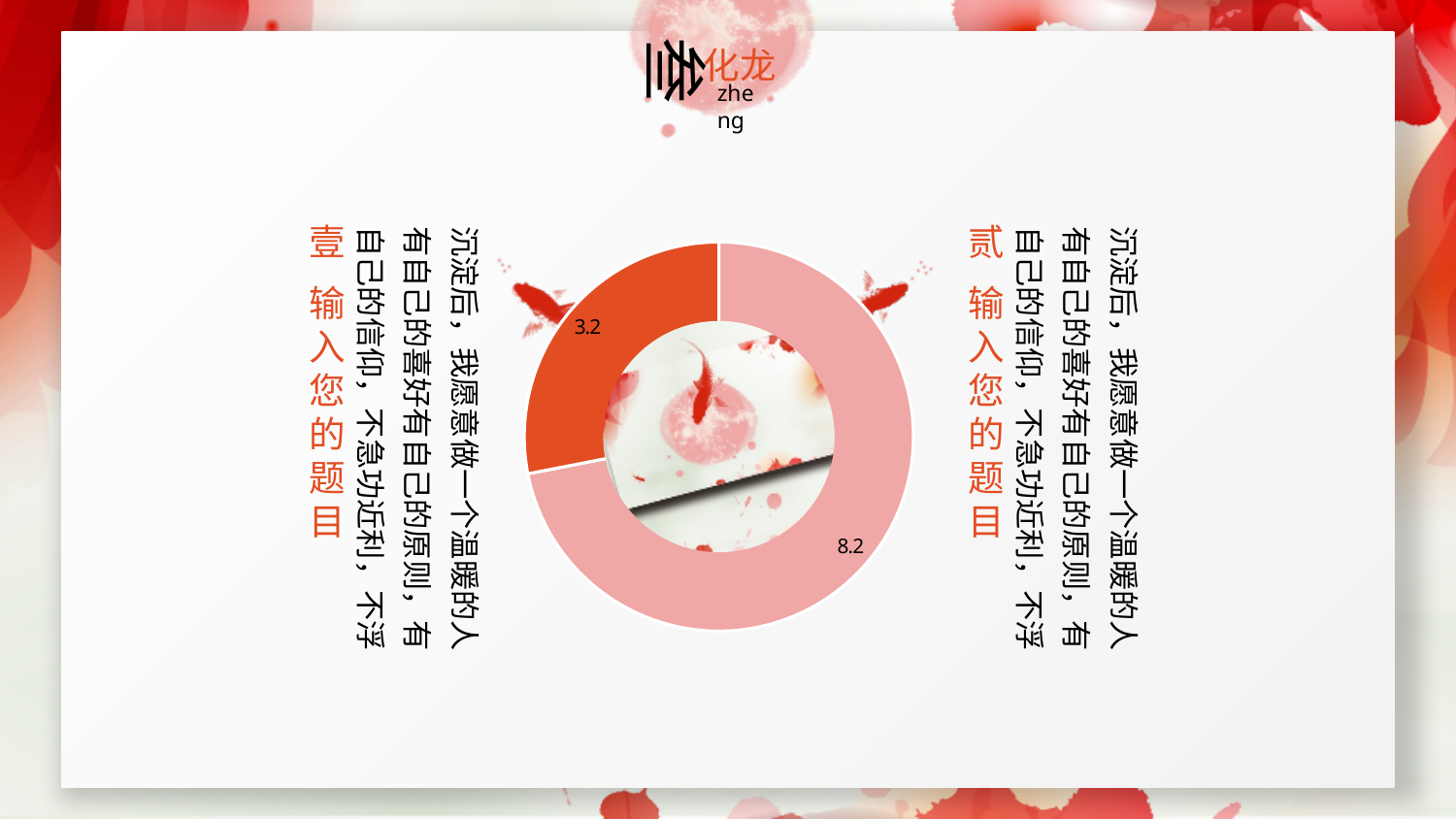
What kind of chart is shown on the slide? Doughnut chart What value is labelled on the larger, pink slice of the doughnut chart? 8.2 What is the total of the two values shown in the doughnut chart? 11.4 What is the difference between the two slice values in the doughnut chart? 5 How many slices does the doughnut chart have? 2 What value is labelled on the smaller, orange-red slice of the doughnut chart? 3.2 Is the value of the pink slice greater or less than 5? greater Which slice is larger in the doughnut chart, the pink one or the orange-red one? The pink one Does the doughnut chart display a legend? No What is the highest value shown in the doughnut chart? 8.2 What is the lowest value shown in the doughnut chart? 3.2 What colour is the slice labelled 3.2 in the doughnut chart? Orange-red